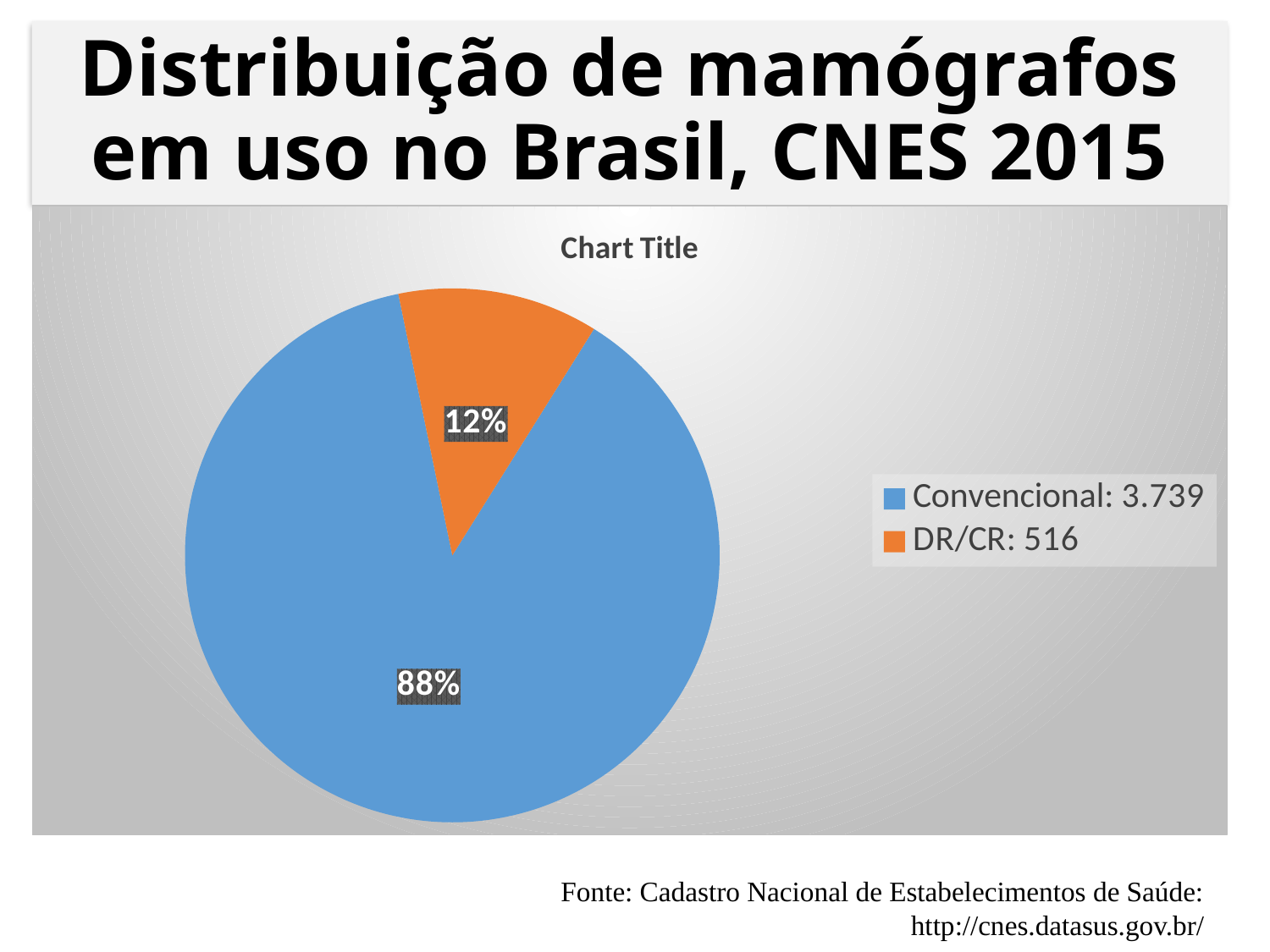
Which category has the smallest slice of the pie? DR/CR How many slices does the pie chart have? 2 Which category has the largest slice of the pie? Convencional What value is shown for Convencional in the legend? 3.739 How many entries does the legend list? 2 What value is shown for DR/CR in the legend? 516 What share of the pie does the DR/CR slice represent? 12% What share of the pie does the Convencional slice represent? 88% What kind of chart is shown on the slide? pie chart What colour is the DR/CR slice? orange What is the difference in percentage points between the Convencional and DR/CR slices? 76 percentage points Which is larger, the Convencional slice or the DR/CR slice? Convencional